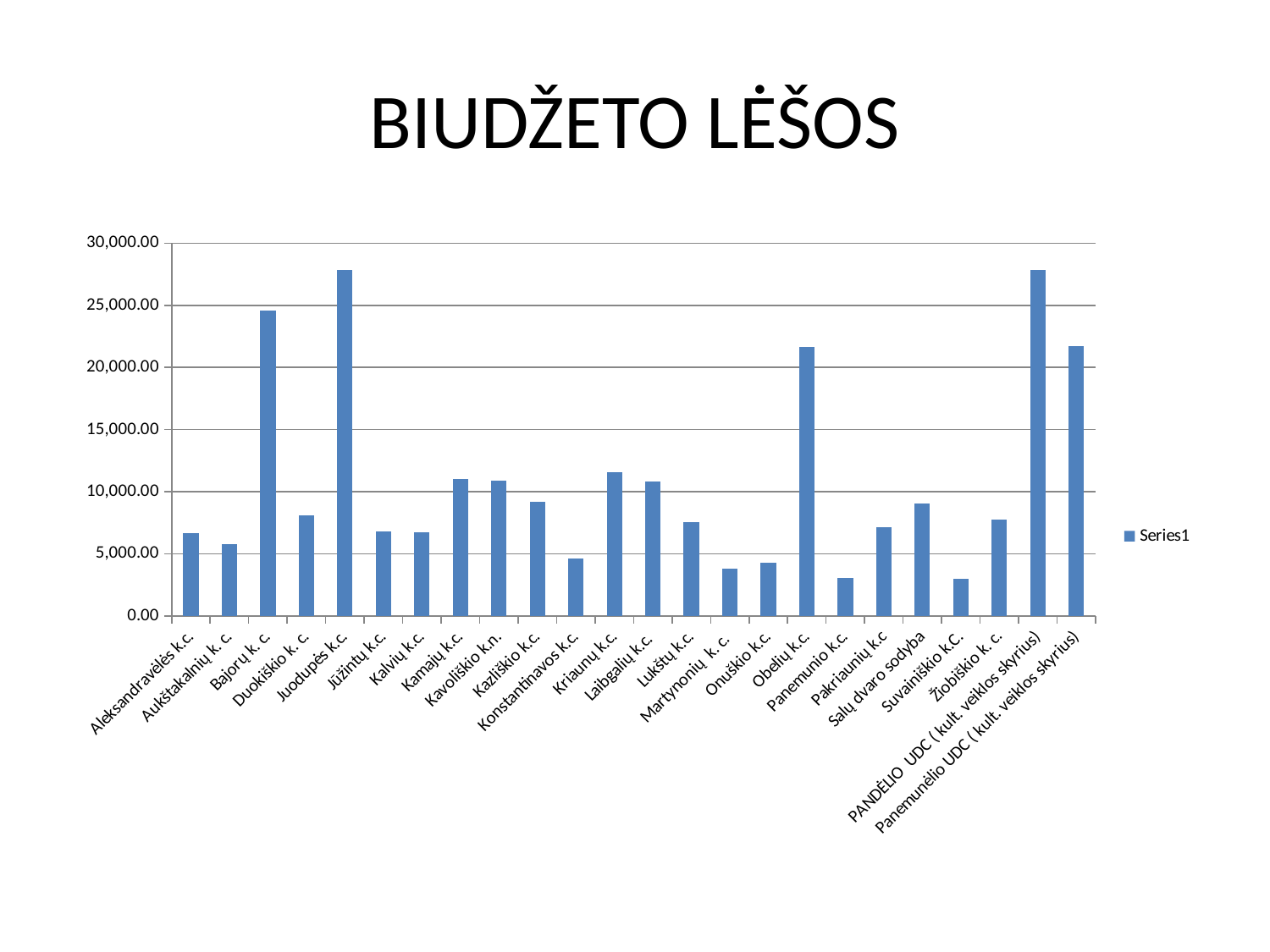
Is the value for Juodupės k.c. greater or less than 25,000.00? greater Is the value for Salų dvaro sodyba greater or less than 10,000.00? less How many series does the legend list? 1 How many categories are shown on the x axis? 24 Which has the larger value, Bajorų k. c. or Obelių k.c.? Bajorų k. c. Which has the larger value, Duokiškio k. c. or Aleksandravėlės k.c.? Duokiškio k. c. Which has the larger value, Kriaunų k.c. or Lukštų k.c.? Kriaunų k.c. What kind of chart is shown on the slide? bar chart What is the title of the slide? BIUDŽETO LĖŠOS Is the value for Kriaunų k.c. greater or less than 10,000.00? greater